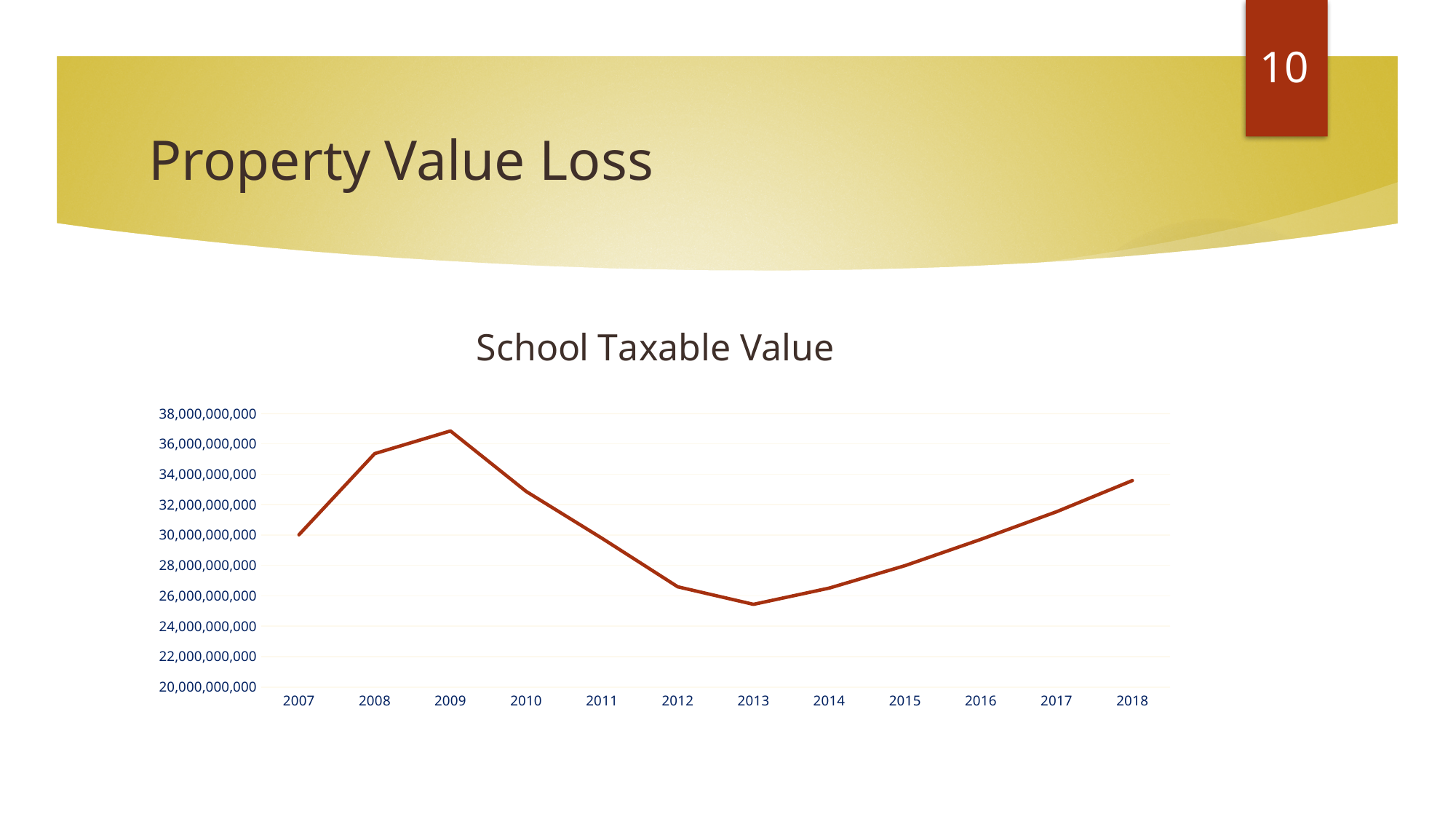
What is the title of the chart? School Taxable Value Is the value for 2008 greater or less than 34,000,000,000? greater How many years are plotted on the x axis of the chart? 12 Which year has the larger School Taxable Value, 2008 or 2018? 2008 What kind of chart is shown on the slide? Line chart Is the value for 2010 greater or less than 32,000,000,000? greater Does the School Taxable Value rise or fall from 2013 to 2018? Rise In which year is the School Taxable Value highest? 2009 Is the value for 2013 greater or less than 26,000,000,000? less In which year is the School Taxable Value lowest? 2013